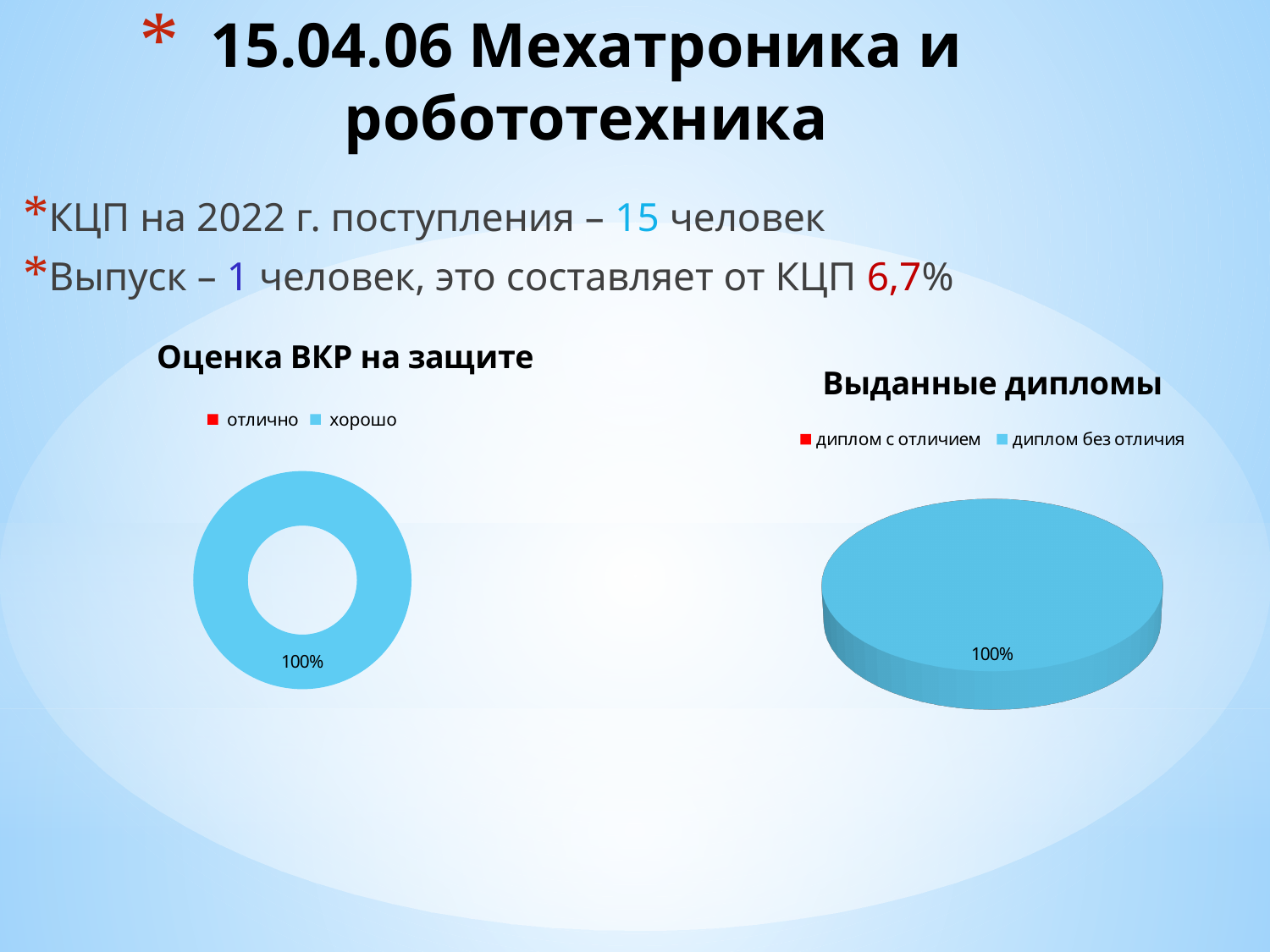
What kind of chart is the chart titled "Оценка ВКР на защите"? doughnut chart In the chart titled "Оценка ВКР на защите", which category is larger: "отлично" or "хорошо"? хорошо In the chart titled "Выданные дипломы", what share is labelled on the chart? 100% What kind of chart is the chart titled "Выданные дипломы"? pie chart In the chart titled "Оценка ВКР на защите", which legend category accounts for 100% of the chart? хорошо In the chart titled "Выданные дипломы", which legend category accounts for 100% of the pie? диплом без отличия In the chart titled "Выданные дипломы", how many series does the legend list? 2 In the chart titled "Оценка ВКР на защите", what colour is the legend entry "отлично"? red In the chart titled "Оценка ВКР на защите", what share is labelled on the chart? 100% In the chart titled "Выданные дипломы", which category is larger: "диплом с отличием" or "диплом без отличия"? диплом без отличия In the chart titled "Оценка ВКР на защите", how many series does the legend list? 2 In the chart titled "Выданные дипломы", what are the two legend entries? диплом с отличием, диплом без отличия